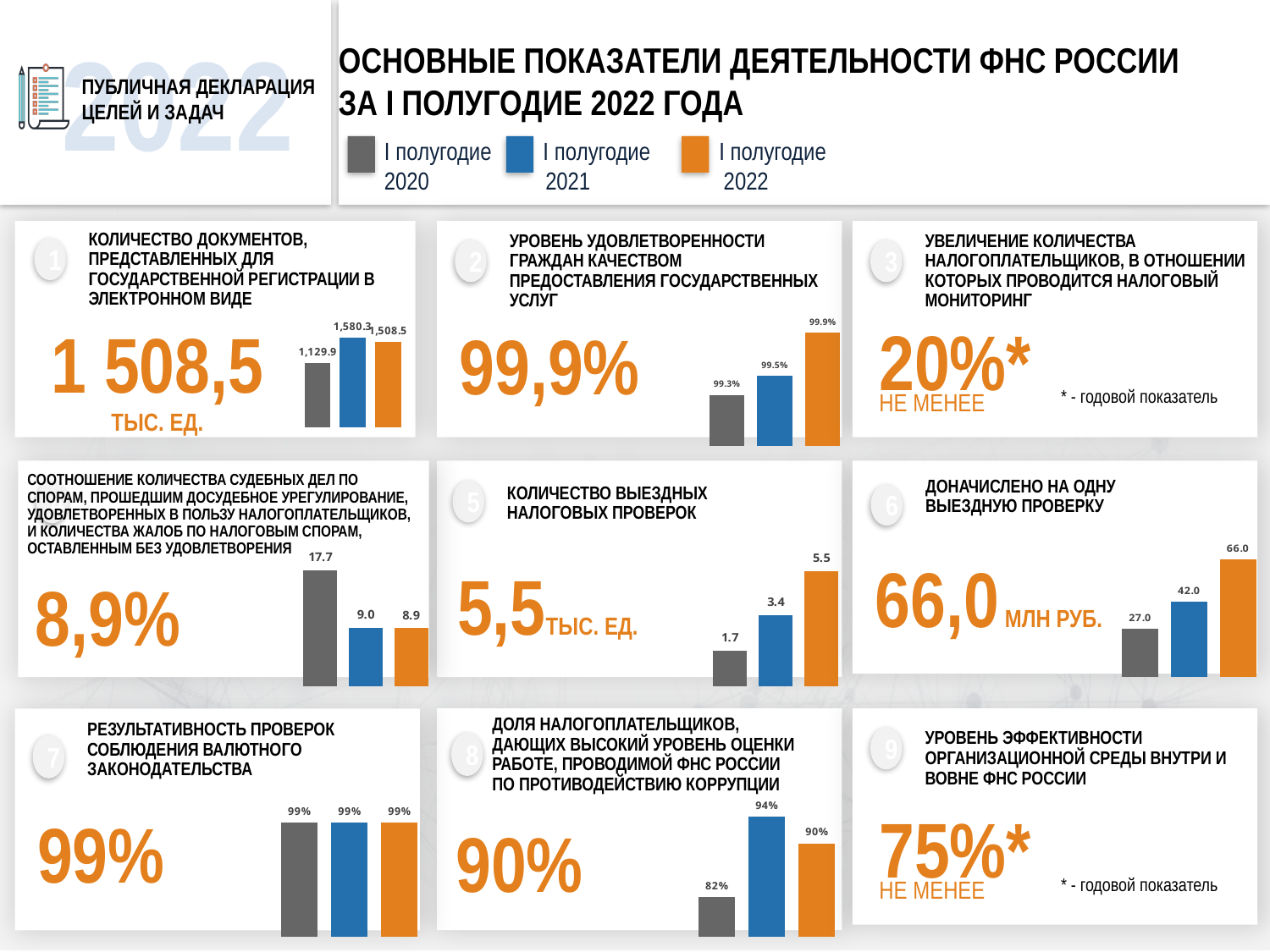
How many bars are in the chart for panel 7 (Результативность проверок соблюдения валютного законодательства)? 3 In the chart for panel 5 (Количество выездных налоговых проверок), what is the value for I полугодие 2021? 3.4 In the chart for panel 8 (Доля налогоплательщиков, дающих высокий уровень оценки...), which is larger: the value for I полугодие 2021 or I полугодие 2022? I полугодие 2021 In the chart for panel 8 (Доля налогоплательщиков...), what is the value for I полугодие 2020? 82% In the chart for panel 4 (Соотношение количества судебных дел...), which period has the highest value? I полугодие 2020 In the chart for panel 1 (Количество документов, представленных для государственной регистрации в электронном виде), what is the value for I полугодие 2021? 1,580.3 In the chart for panel 1 (Количество документов...), which period has the lowest value? I полугодие 2020 In the chart for panel 6 (Доначислено на одну выездную проверку), what is the difference between the I полугодие 2022 value and the I полугодие 2020 value? 39.0 In the chart for panel 5 (Количество выездных налоговых проверок), do the values rise or fall from 2020 to 2022? rise In the chart for panel 4 (Соотношение количества судебных дел...), what is the difference between the I полугодие 2020 value and the I полугодие 2022 value? 8.8 According to the legend at the top of the slide, which period do the orange bars represent? I полугодие 2022 In the chart for panel 2 (Уровень удовлетворенности граждан...), what is the value for I полугодие 2022? 99.9%